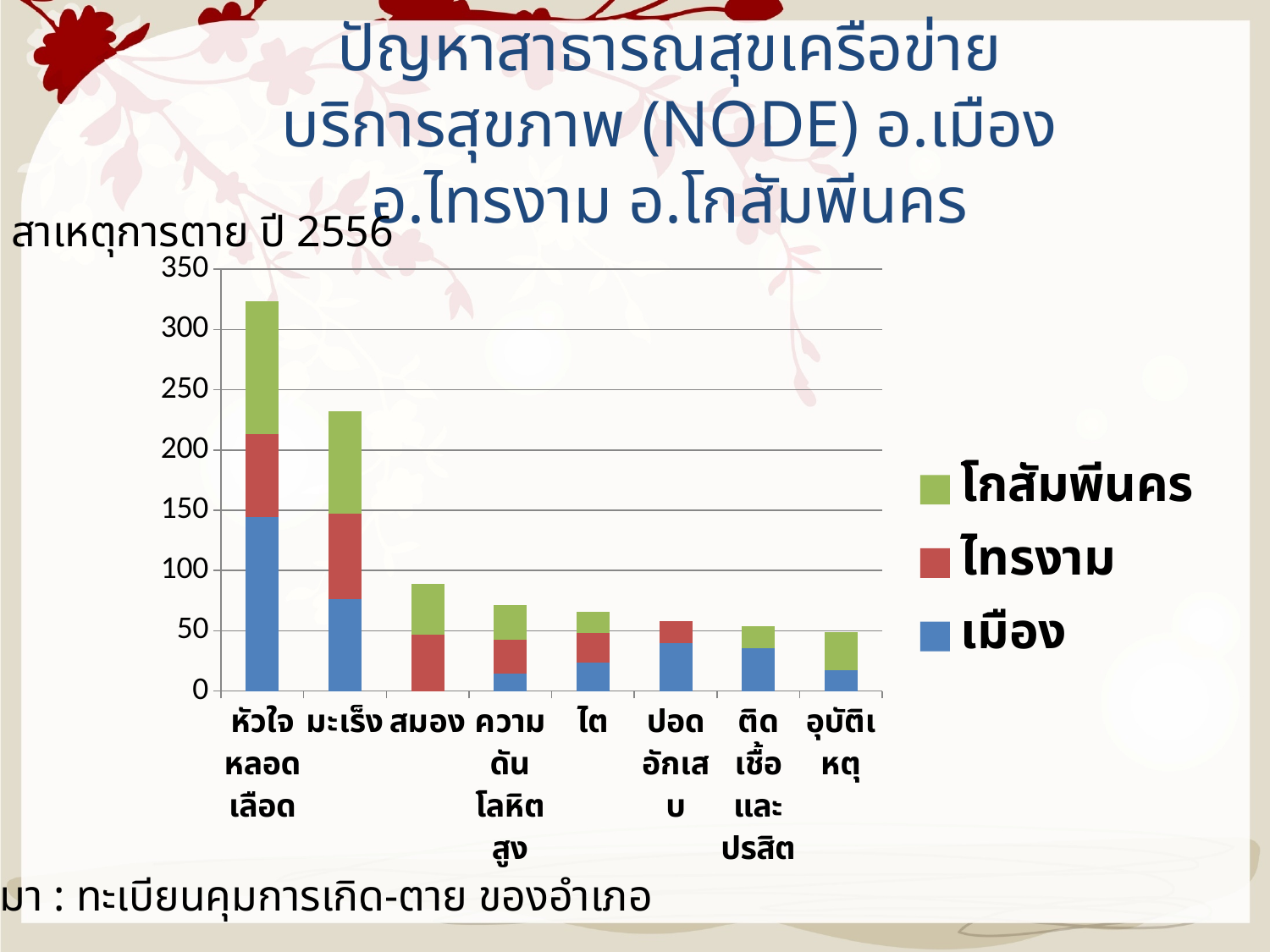
Is the total value for สมอง greater or less than 100? less Which series is shown in blue in the legend? เมือง Is the total value for หัวใจหลอดเลือด greater or less than 300? greater What kind of chart is shown on the slide? stacked bar chart Which has a larger total, หัวใจหลอดเลือด or มะเร็ง? หัวใจหลอดเลือด How many series does the legend list? 3 How many categories (causes of death) are shown on the x axis? 8 Which category has the highest total stacked bar? หัวใจหลอดเลือด Is the เมือง value for ปอดอักเสบ greater or less than 50? less What is the title of the chart? สาเหตุการตาย ปี 2556 Do the total bar heights generally rise or fall from left to right along the x axis? fall